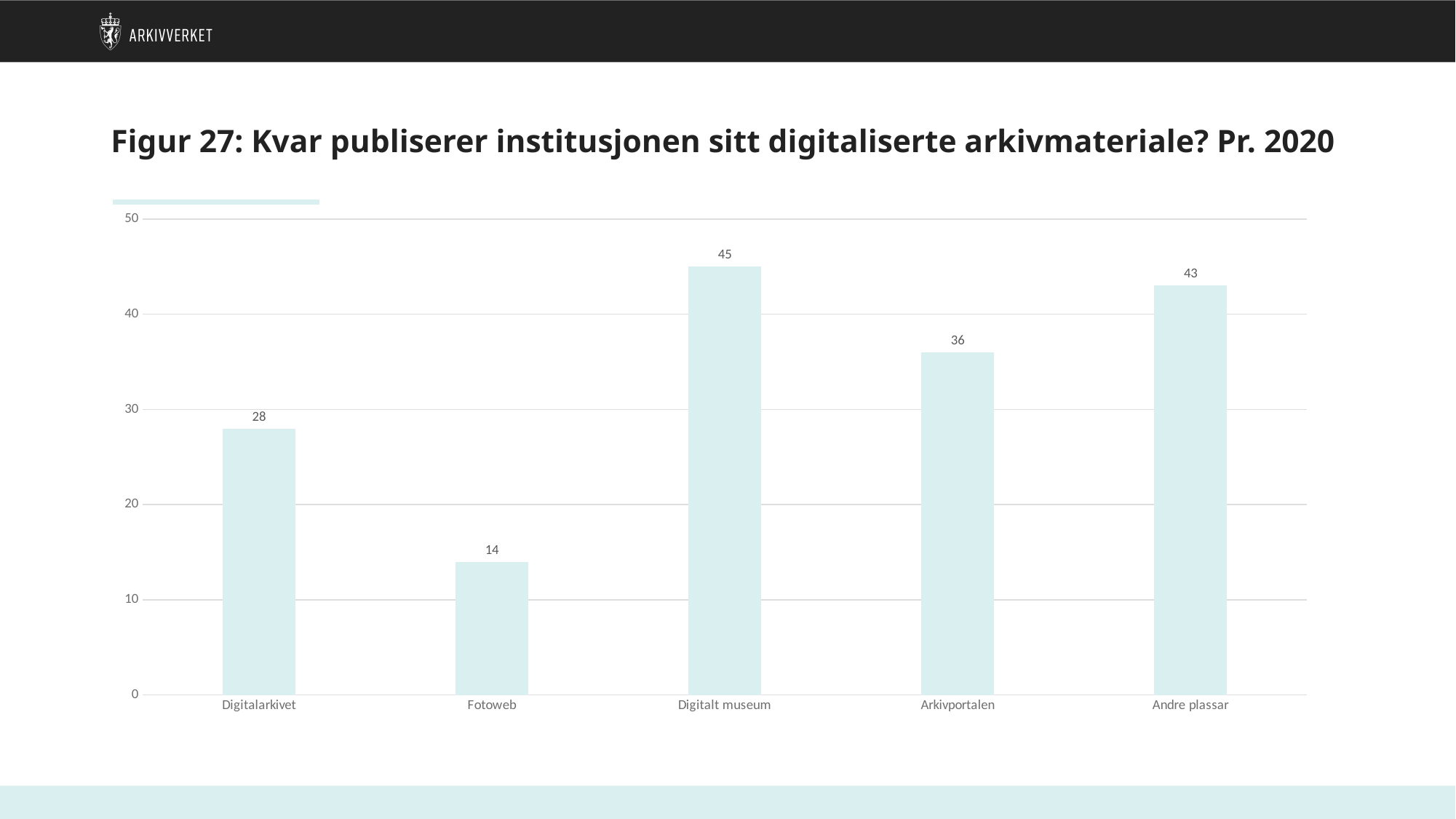
Which is larger, the value for Digitalarkivet or the value for Arkivportalen? Arkivportalen Which category has the lowest value? Fotoweb What is the value for Digitalt museum? 45 What is the title of the chart? Figur 27: Kvar publiserer institusjonen sitt digitaliserte arkivmateriale? Pr. 2020 What is the value for Arkivportalen? 36 Which category has the highest value? Digitalt museum What is the value for Andre plassar? 43 What is the value for Fotoweb? 14 What is the value for Digitalarkivet? 28 What is the difference between the values for Digitalt museum and Arkivportalen? 9 What kind of chart is shown on the slide? Bar chart How many categories are shown in the chart? 5